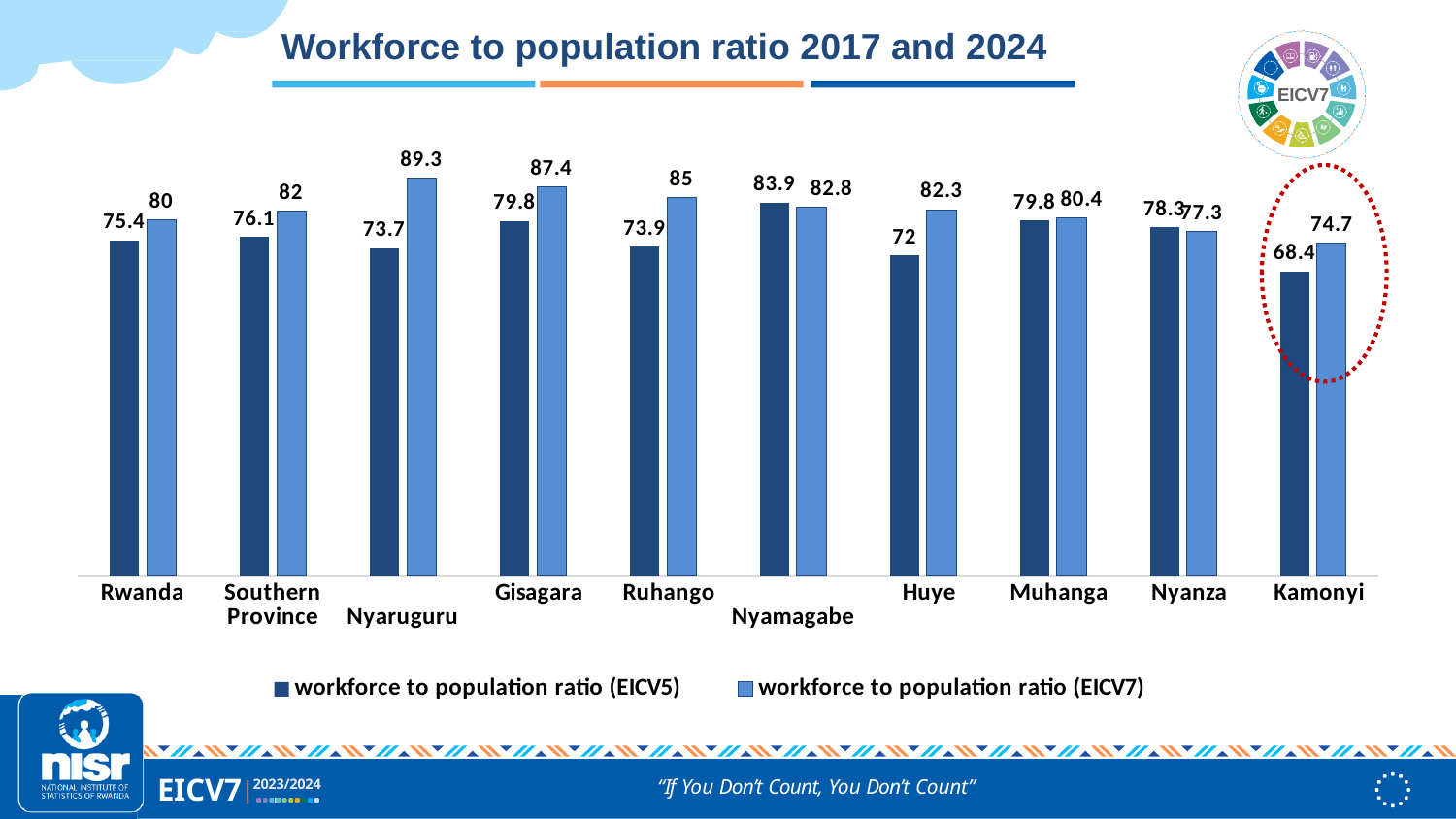
What type of chart is shown on the slide? Bar chart What is the difference between the EICV7 and EICV5 workforce to population ratios for Kamonyi? 6.3 What is the workforce to population ratio (EICV5) for Kamonyi? 68.4 How many categories are shown on the x axis of the chart? 10 What is the difference between the EICV7 and EICV5 workforce to population ratios for Nyaruguru? 15.6 What is the workforce to population ratio (EICV7) for Nyaruguru? 89.3 Which district or region has the highest workforce to population ratio (EICV5)? Nyamagabe Which district or region has the lowest workforce to population ratio (EICV5)? Kamonyi What is the workforce to population ratio (EICV5) for Huye? 72 How many series does the legend list? 2 For Nyamagabe, which is larger: the EICV5 or the EICV7 workforce to population ratio? EICV5 Which district or region has the highest workforce to population ratio (EICV7)? Nyaruguru